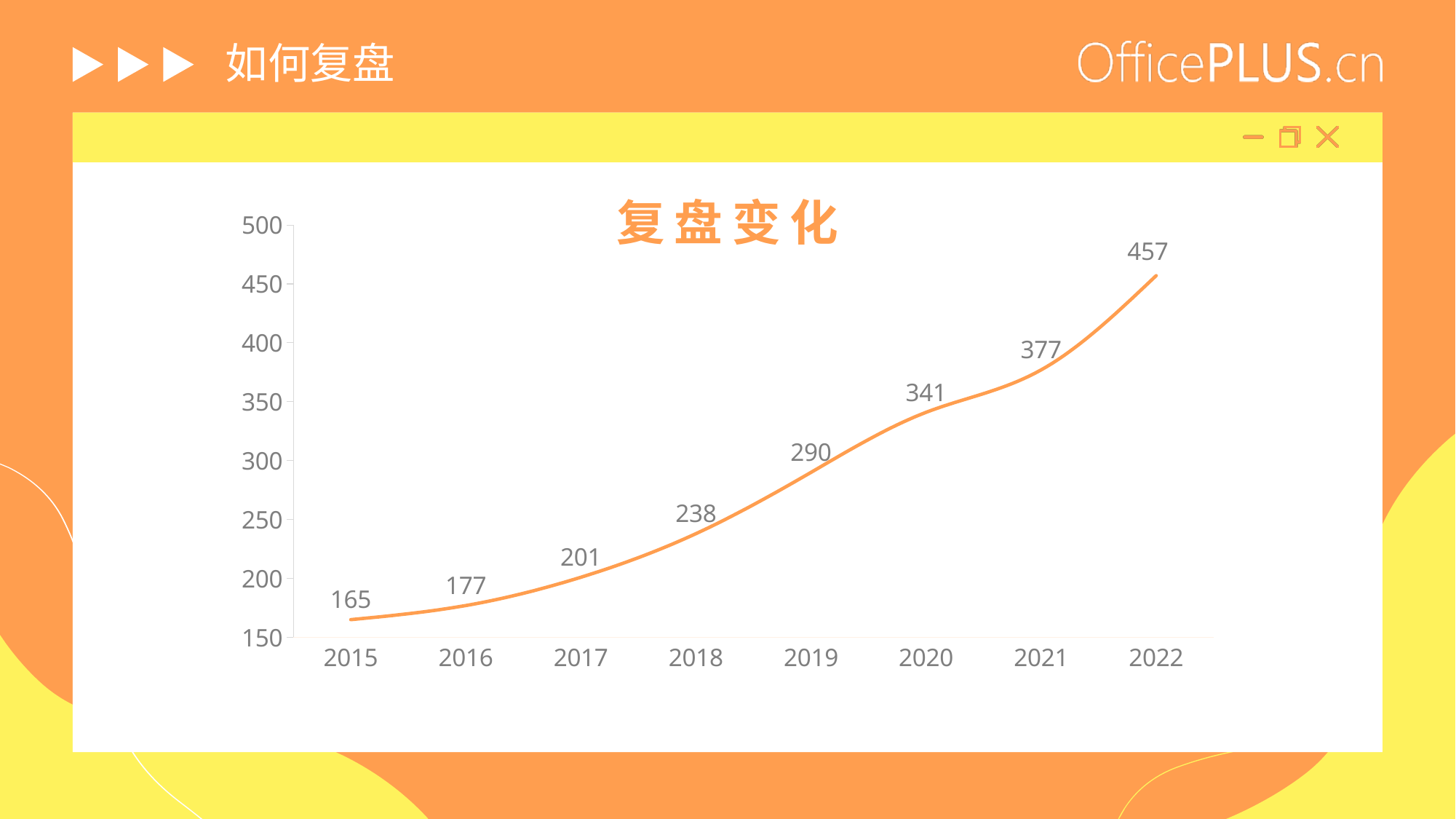
What is the title of the chart? 复盘变化 Do the values rise or fall from 2015 to 2022? rise What is the value for 2022? 457 What kind of chart is shown? line chart What is the difference between the values for 2022 and 2021? 80 What is the difference between the values for 2018 and 2017? 37 Which is larger, the value for 2020 or the value for 2018? 2020 Which year has the lowest value? 2015 How many years are plotted on the x axis? 8 What is the value for 2019? 290 What is the value for 2015? 165 Which year has the highest value? 2022